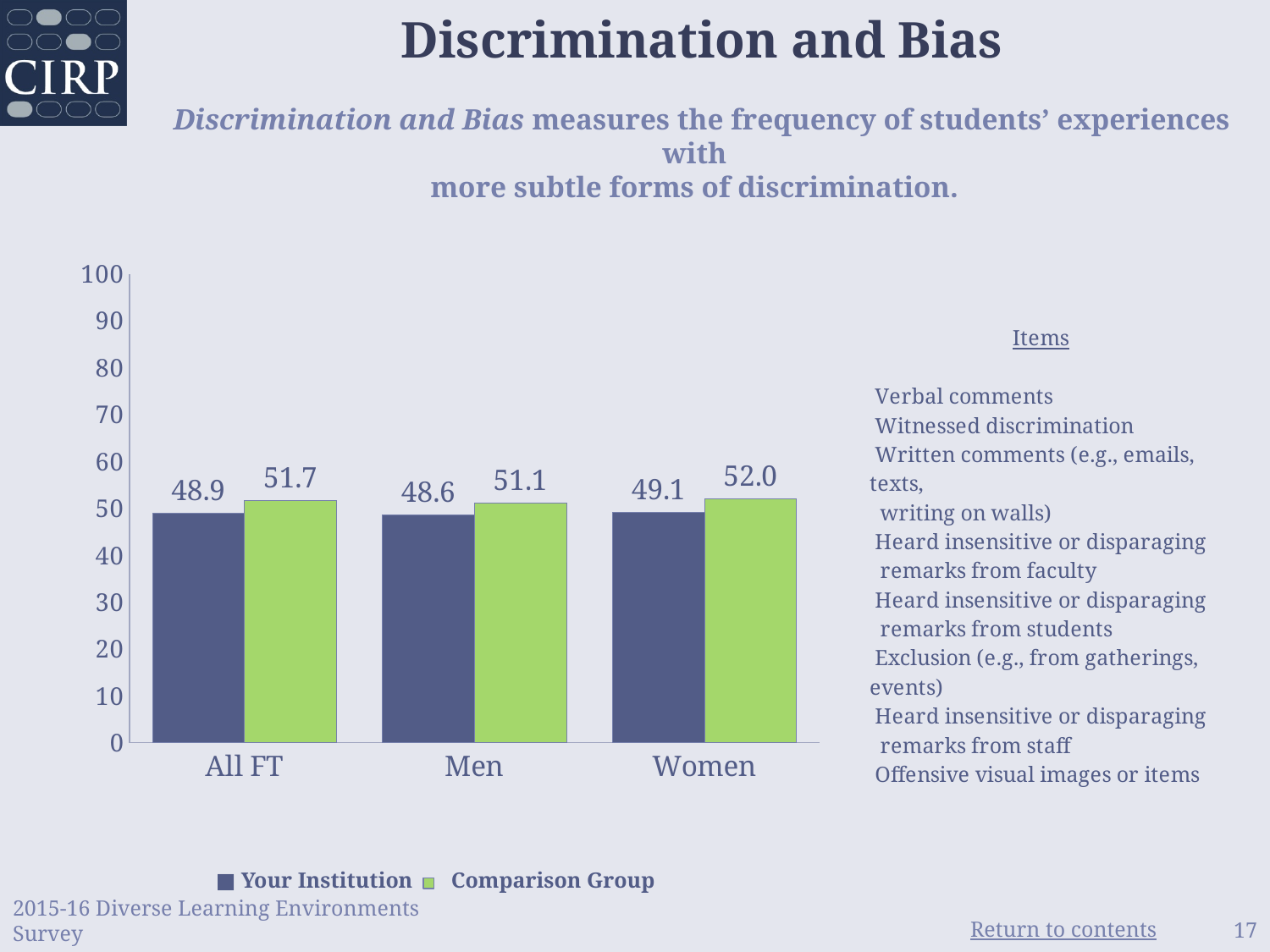
Which category has the highest Comparison Group value? Women What colour are the Comparison Group bars? green What is the value for Your Institution in the All FT category? 48.9 For Women, which is larger: Your Institution or Comparison Group? Comparison Group Is the value for Comparison Group in the Men category greater or less than 50? greater How many series does the legend list? 2 What kind of chart is shown on the slide? bar chart Which category has the lowest Your Institution value? Men What is the value for Your Institution in the Men category? 48.6 How many categories are shown on the x axis? 3 What is the difference between the Comparison Group and Your Institution values for All FT? 2.8 What is the value for Comparison Group in the Women category? 52.0